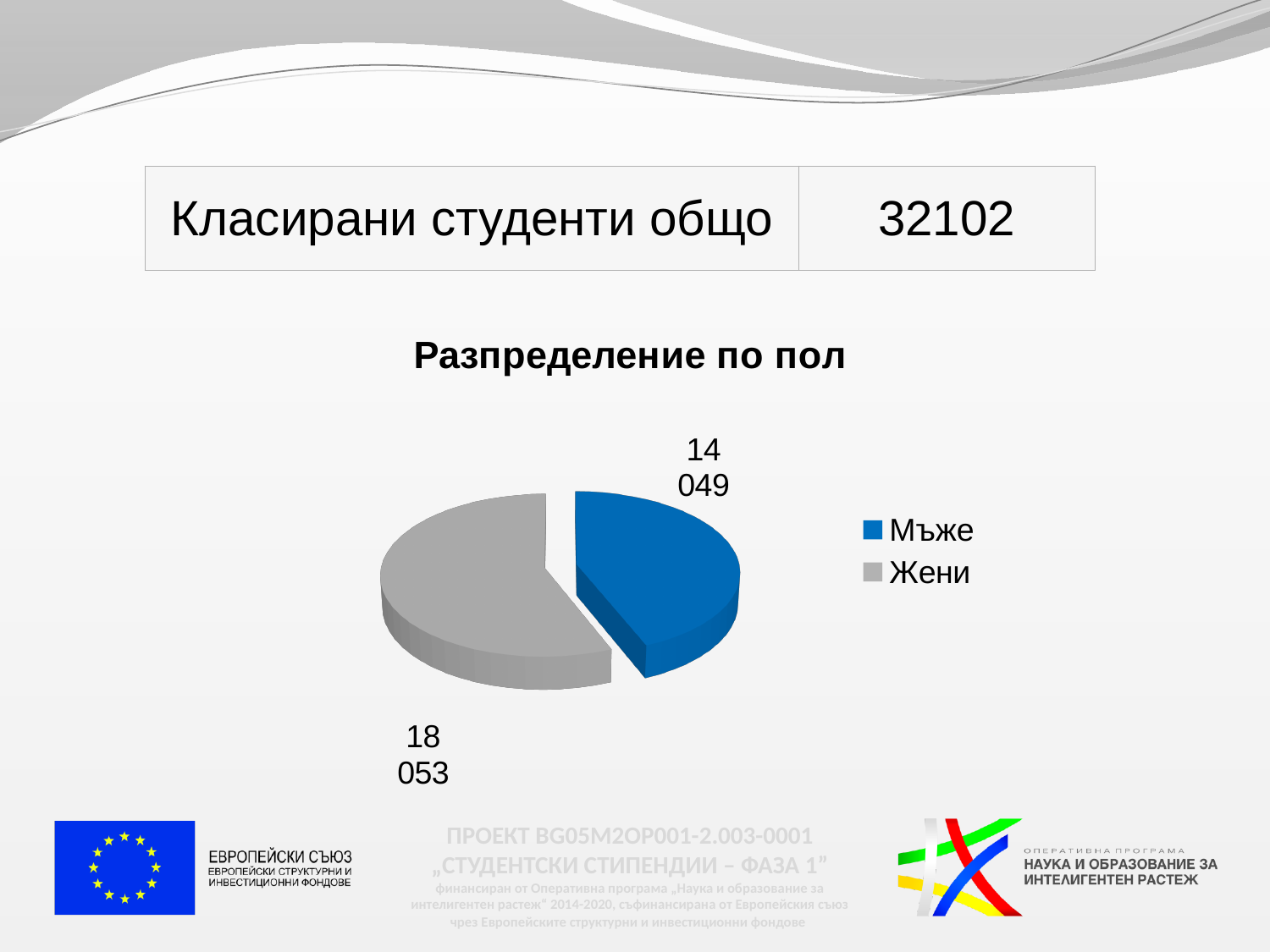
What is the value for Мъже in the pie chart? 14 049 Which category has the smallest slice in the pie chart? Мъже How many slices does the pie chart have? 2 What colour is the slice for Мъже? blue Which category has the largest slice in the pie chart? Жени What is the difference between the values for Жени and Мъже? 4 004 What is the title of the chart? Разпределение по пол How many entries does the legend list? 2 What is the value for Жени in the pie chart? 18 053 What is the total of the two slices in the pie chart? 32102 What type of chart is shown on the slide? pie chart Which is larger, the value for Мъже or the value for Жени? Жени